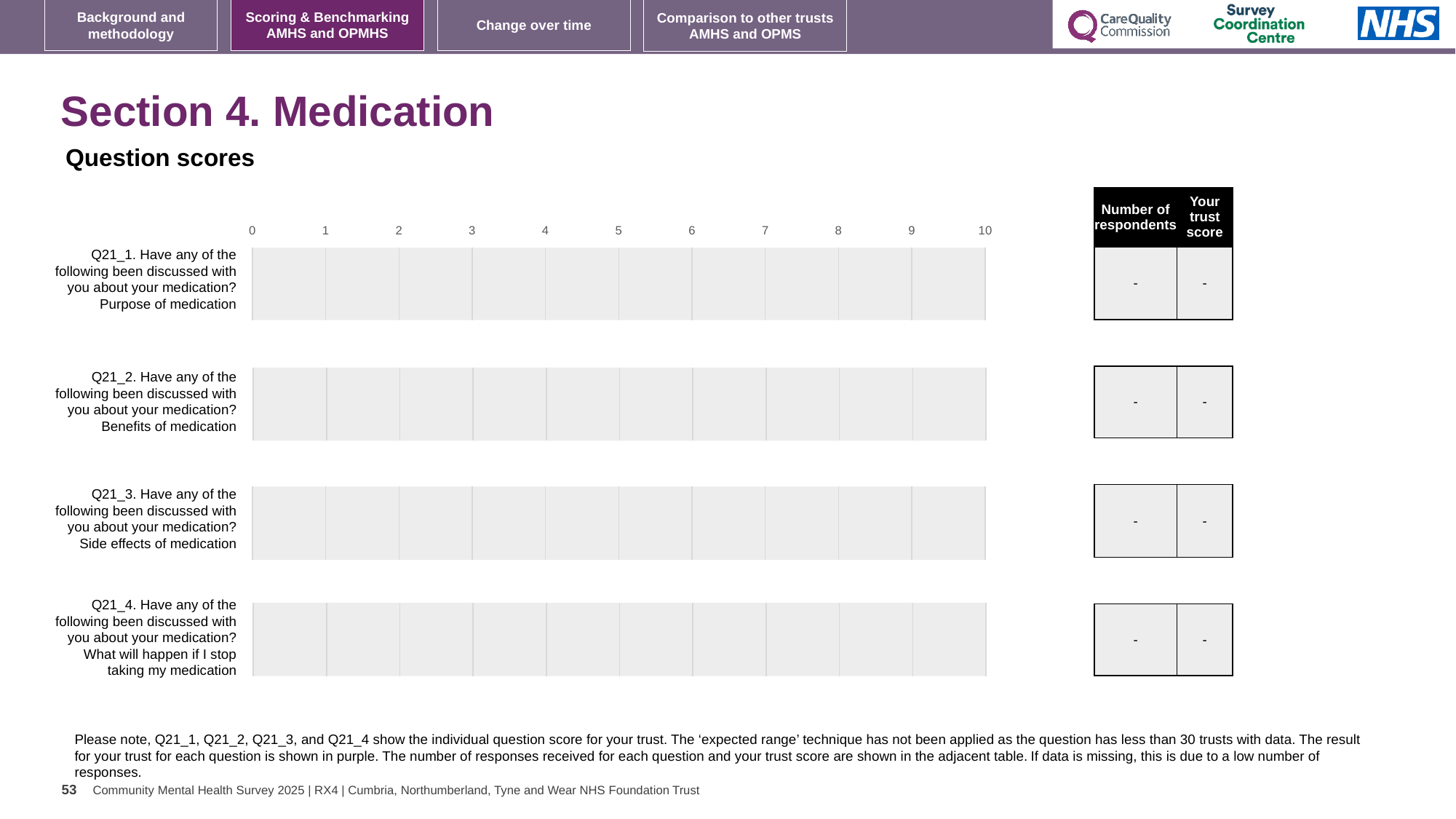
What is the 'Your trust score' value shown for Q21_1 (Purpose of medication)? - What is the section title shown above the Question scores chart? Section 4. Medication What is the highest value shown on the horizontal axis of the Question scores chart? 10 What is the 'Number of respondents' value shown for Q21_2 (Benefits of medication)? - What is the 'Number of respondents' value shown for Q21_4 (What will happen if I stop taking my medication)? - How many questions (categories) are shown on the Question scores chart? 4 What is the lowest value shown on the horizontal axis of the Question scores chart? 0 What is the 'Your trust score' value shown for Q21_3 (Side effects of medication)? -